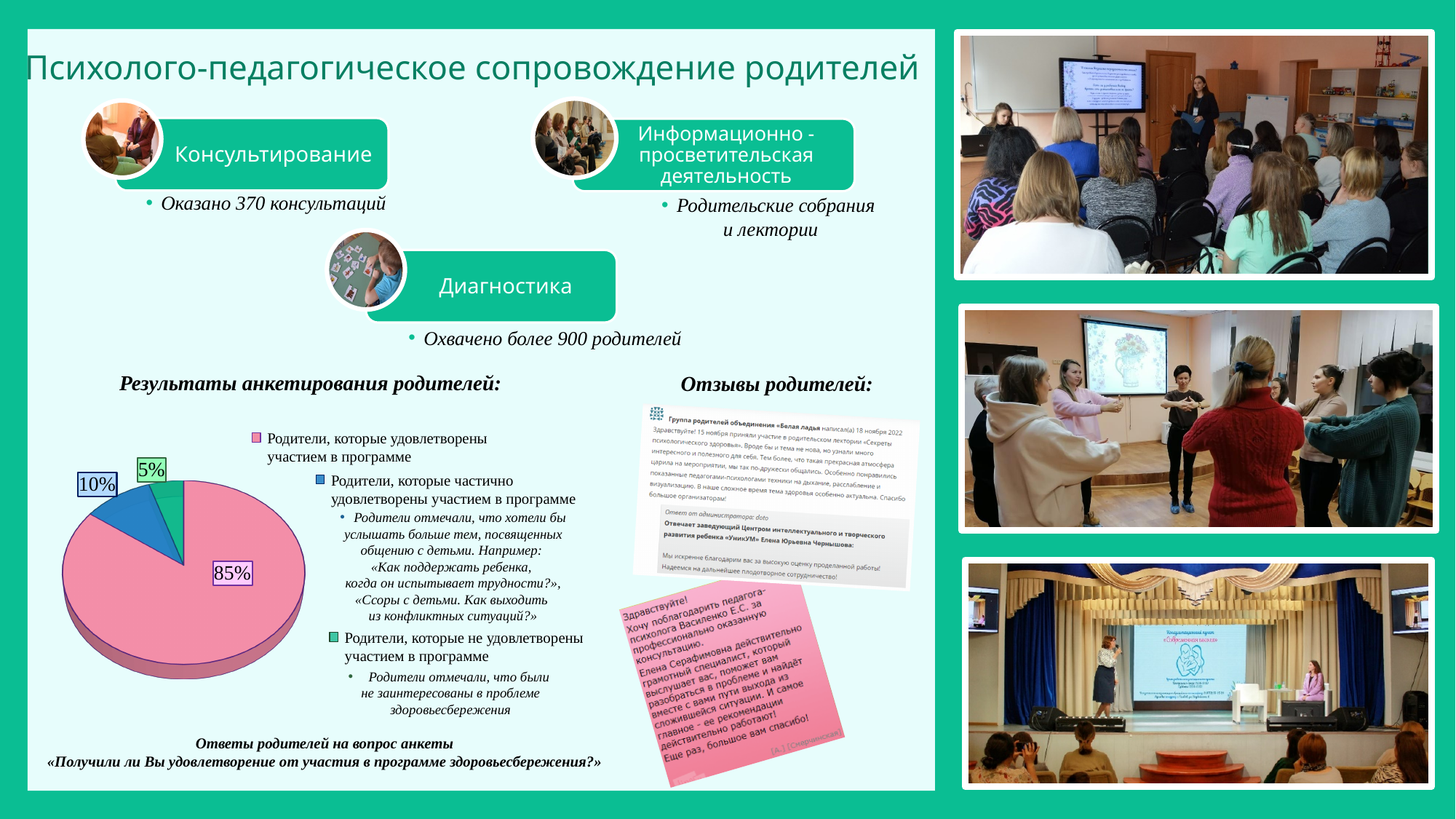
Что больше на круговой диаграмме: доля частично удовлетворённых родителей или доля не удовлетворённых? Доля частично удовлетворённых родителей На сколько процентных пунктов доля удовлетворённых родителей больше доли частично удовлетворённых на круговой диаграмме? 75 Какая категория родителей занимает наибольшую долю на круговой диаграмме? Родители, которые удовлетворены участием в программе Сколько записей содержит легенда круговой диаграммы? 3 Какая категория родителей занимает наименьшую долю на круговой диаграмме? Родители, которые не удовлетворены участием в программе Какая доля родителей не удовлетворена участием в программе согласно круговой диаграмме? 5% Каким цветом на круговой диаграмме обозначены родители, которые удовлетворены участием в программе? Розовым Сколько категорий (секторов) показано на круговой диаграмме? 3 Какой тип диаграммы показан на слайде в разделе «Результаты анкетирования родителей»? Круговая диаграмма Какая доля родителей удовлетворена участием в программе согласно круговой диаграмме? 85% На сколько процентных пунктов доля частично удовлетворённых родителей больше доли не удовлетворённых на круговой диаграмме? 5 Какая доля родителей частично удовлетворена участием в программе согласно круговой диаграмме? 10%